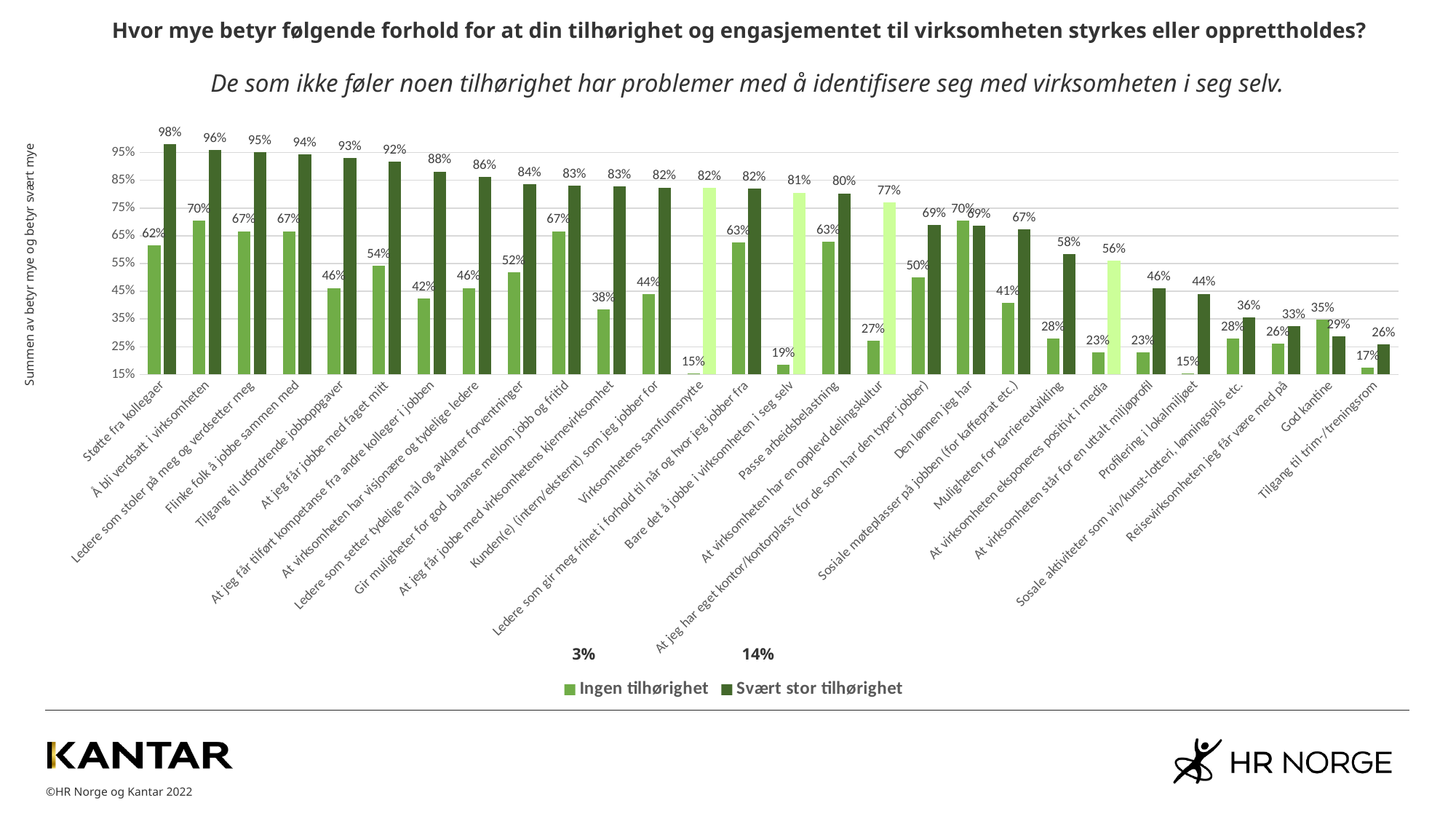
What is the 'Svært stor tilhørighet' value for 'Muligheten for karriereutvikling'? 58% What is the 'Ingen tilhørighet' value for 'At jeg får jobbe med faget mitt'? 54% Which category has the lowest value for 'Svært stor tilhørighet'? Tilgang til trim-/treningsrom Which is larger: the 'Ingen tilhørighet' value for 'Å bli verdsatt i virksomheten' or for 'Tilgang til utfordrende jobboppgaver'? Å bli verdsatt i virksomheten What is the 'Ingen tilhørighet' value for 'God kantine'? 35% What is the difference between the 'Svært stor tilhørighet' and 'Ingen tilhørighet' values for 'Støtte fra kollegaer'? 36 percentage points What are the two legend entries of the chart? Ingen tilhørighet; Svært stor tilhørighet What kind of chart is shown on the slide? bar chart Do the 'Svært stor tilhørighet' values generally rise or fall from left to right along the x axis? fall Which category has the highest value for 'Svært stor tilhørighet'? Støtte fra kollegaer What is the 'Svært stor tilhørighet' value for 'Å bli verdsatt i virksomheten'? 96% How many series does the legend list? 2